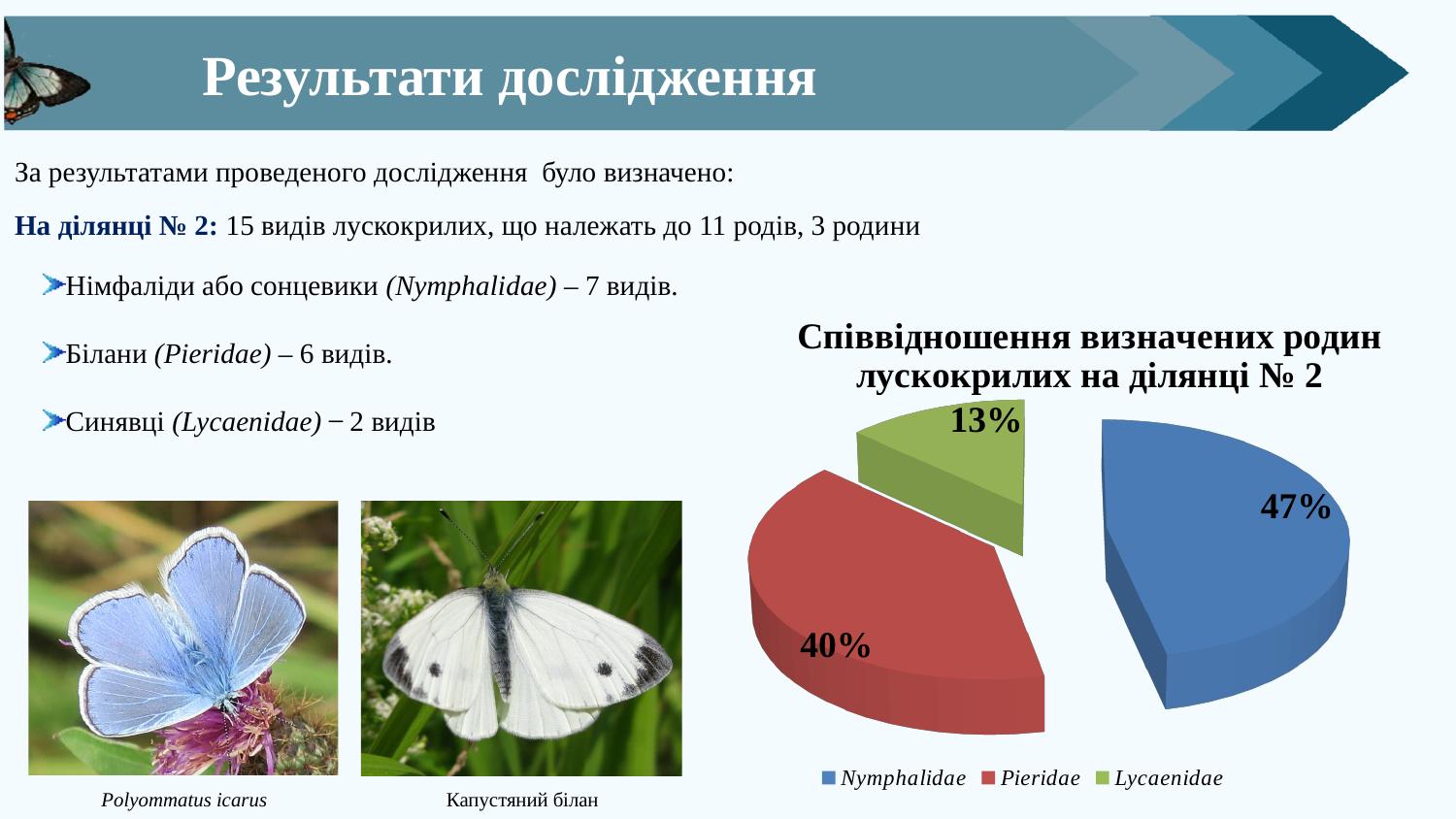
Which slice is larger, Pieridae or Lycaenidae? Pieridae What is the difference in percentage points between the Pieridae and Lycaenidae slices? 27 What share of the pie does Nymphalidae have? 47% How many slices does the pie chart have? 3 What type of chart is shown on the slide? Pie chart What share of the pie does Pieridae have? 40% What is the difference in percentage points between the Nymphalidae and Pieridae slices? 7 What colour is the Lycaenidae slice? Green What share of the pie does Lycaenidae have? 13% Which family has the largest slice of the pie? Nymphalidae What is the title of the chart? Співвідношення визначених родин лускокрилих на ділянці № 2 Which family has the smallest slice of the pie? Lycaenidae